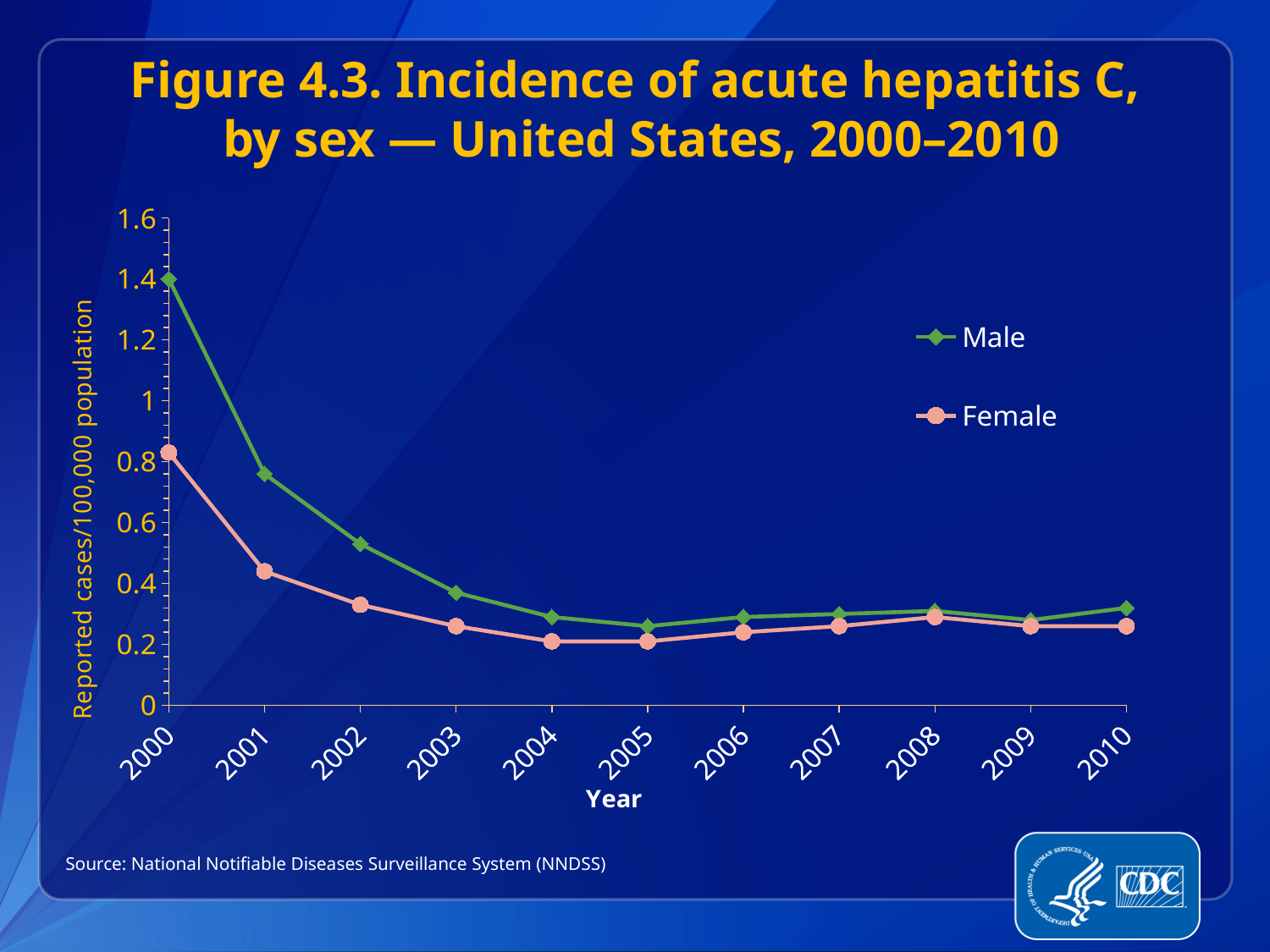
Is the Male value for 2001 greater or less than 0.6? greater What kind of chart is shown on the slide? Line chart Does the Male incidence rise or fall from 2000 to 2004? Fall How many years are plotted along the x axis? 11 In which year is the Female incidence highest? 2000 Is the Female value for 2000 greater or less than 1? less Is the Male value for 2000 greater or less than 1.2? greater In 2000, which series has the larger value, Male or Female? Male What is the label on the y axis? Reported cases/100,000 population In which year is the Male incidence highest? 2000 How many series does the legend list? 2